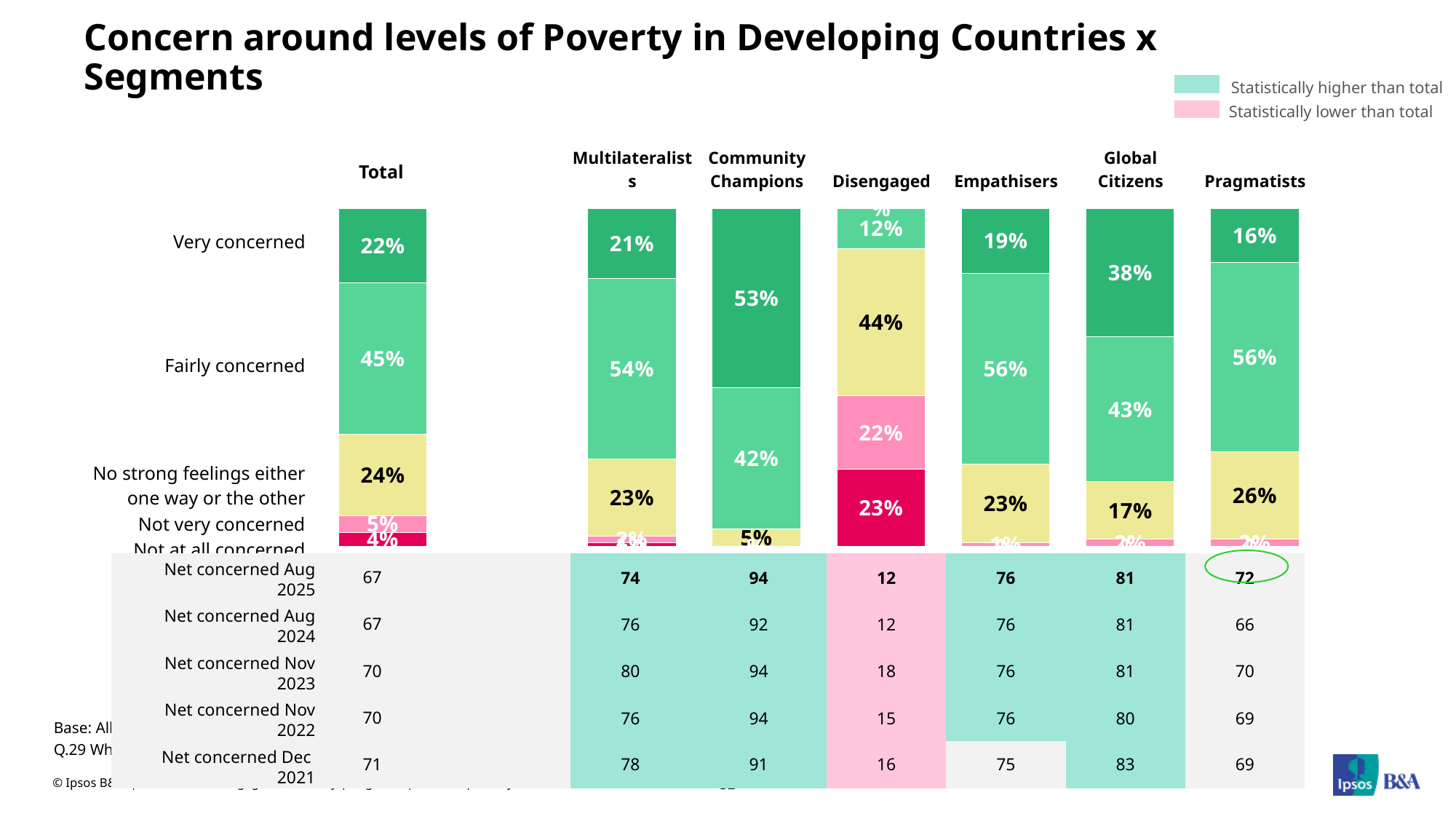
What kind of chart is used to show the concern levels by segment? Stacked bar chart What is the difference in percentage points between the Very concerned share for Global Citizens and for the Total? 16 percentage points Which segment has the lowest share of Fairly concerned respondents? Disengaged What percentage of Disengaged have no strong feelings either one way or the other? 44% What percentage of Global Citizens are Fairly concerned? 43% Which segment has the lowest Net concerned Aug 2025 value? Disengaged What percentage of the Total are Very concerned? 22% Which is larger: the Very concerned share for Community Champions or for Multilateralists? Community Champions What percentage of Community Champions are Very concerned? 53% What is the Net concerned Aug 2025 value for Community Champions? 94 Which segment has the highest share of Very concerned respondents? Community Champions How many segment bars are shown in the chart, including Total? 7